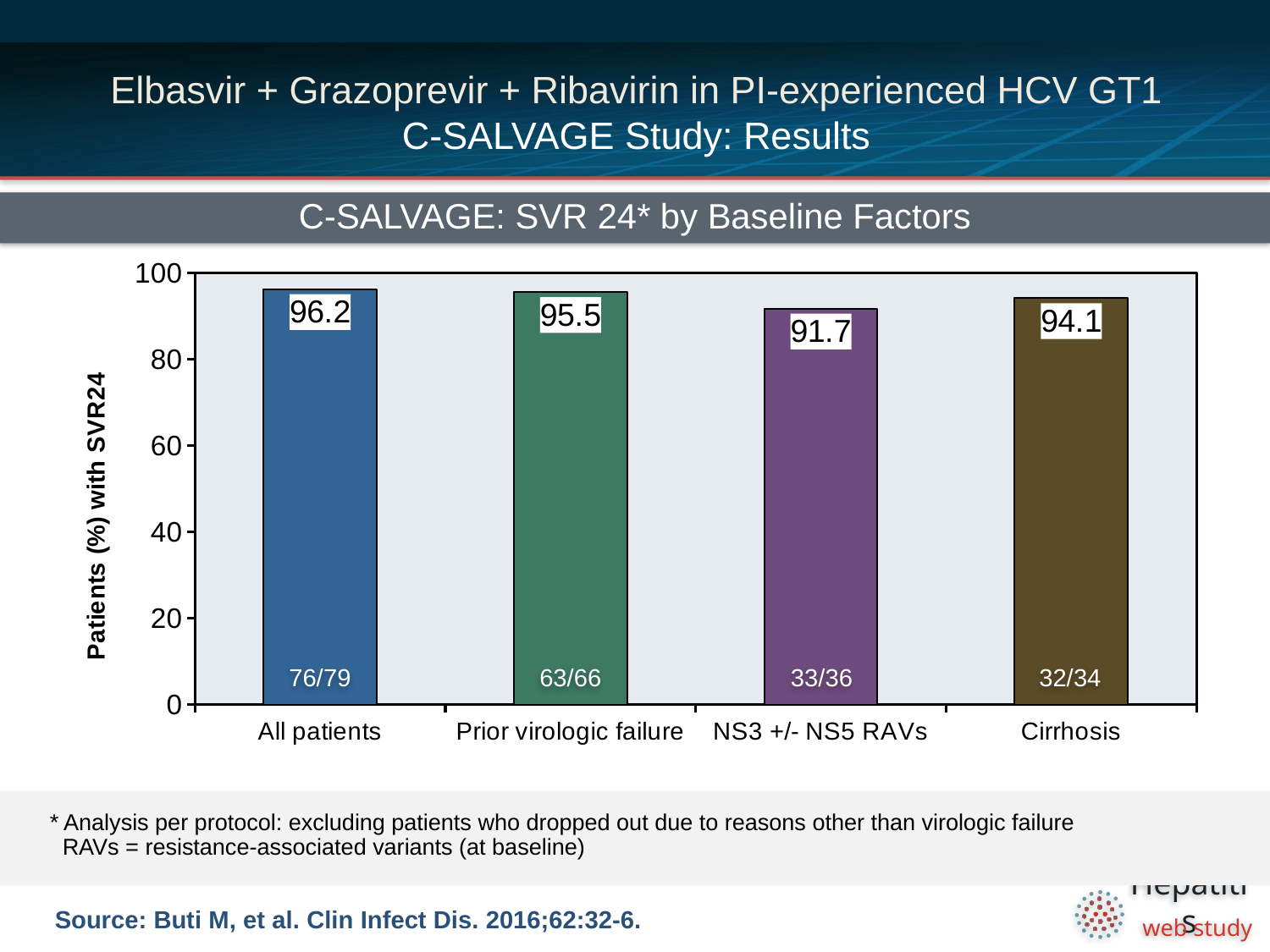
What is the SVR24 rate for patients with NS3 +/- NS5 RAVs? 91.7 What is the SVR24 rate for patients with Cirrhosis? 94.1 Which category has the lowest SVR24 rate? NS3 +/- NS5 RAVs Which category has the highest SVR24 rate? All patients What is the difference between the SVR24 rate for All patients and for NS3 +/- NS5 RAVs? 4.5 What is the title of the chart? C-SALVAGE: SVR 24* by Baseline Factors What fraction of patients is shown at the base of the Prior virologic failure bar? 63/66 What kind of chart is shown on the slide? Bar chart How many categories are shown on the x axis? 4 Which has a higher SVR24 rate, Prior virologic failure or Cirrhosis? Prior virologic failure Is the SVR24 rate for Cirrhosis greater or less than 80? greater What is the SVR24 rate for All patients? 96.2